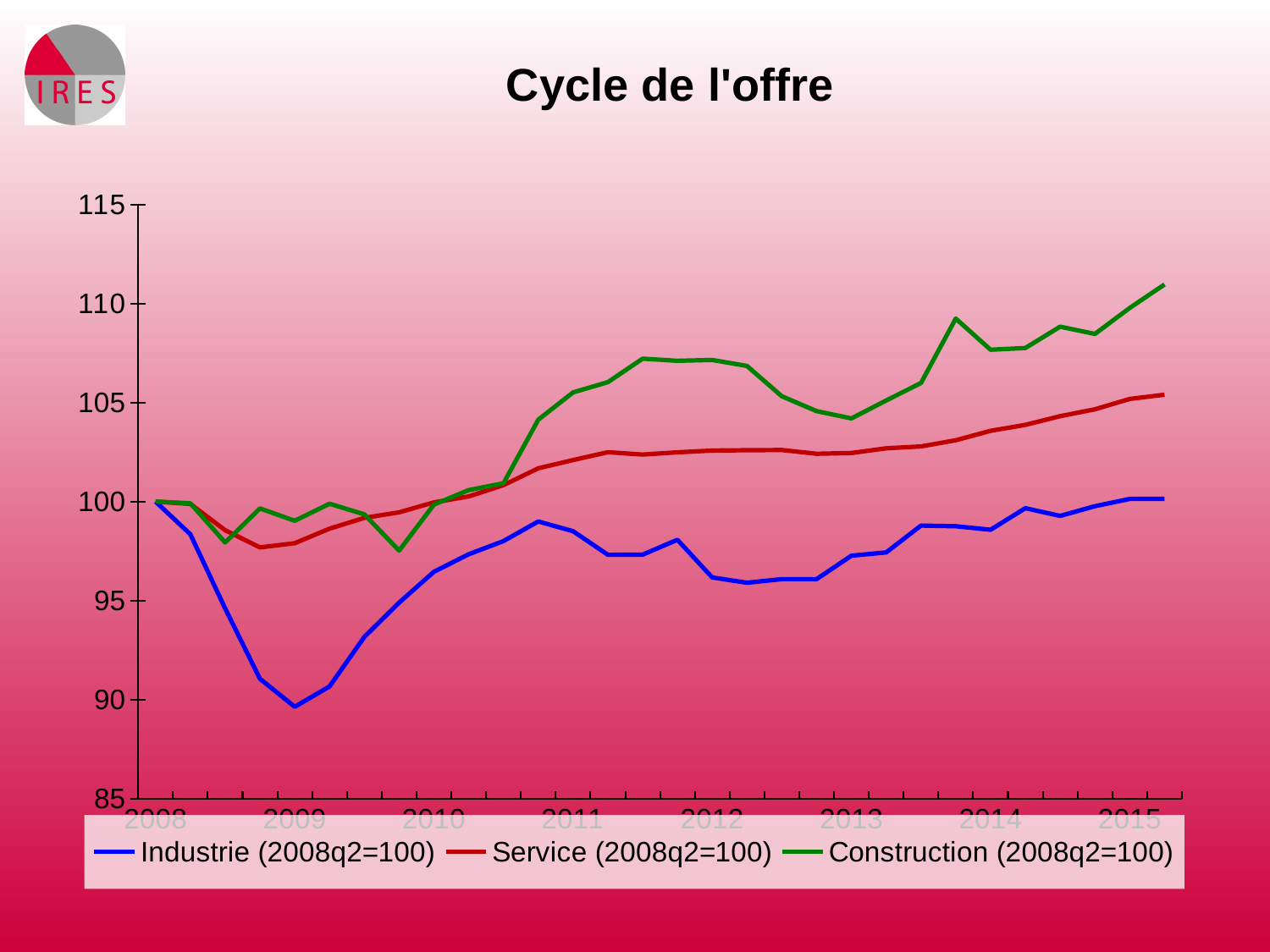
Which colour is used for the Construction (2008q2=100) series? green At the start of 2009, which is larger: Industrie (2008q2=100) or Service (2008q2=100)? Service (2008q2=100) What kind of chart is shown on the slide? line chart How many series does the legend list? 3 Does the Industrie (2008q2=100) series rise or fall between 2008 and the start of 2009? fall Is the value for Construction (2008q2=100) at the start of 2012 greater or less than 105? greater Which series has the highest value at the end of the chart in 2015? Construction (2008q2=100) Is the value for Industrie (2008q2=100) at the start of 2009 greater or less than 95? less Is the value for Service (2008q2=100) at the start of 2015 greater or less than 100? greater What is the title of the chart? Cycle de l'offre Which series reaches the lowest value in 2009? Industrie (2008q2=100)